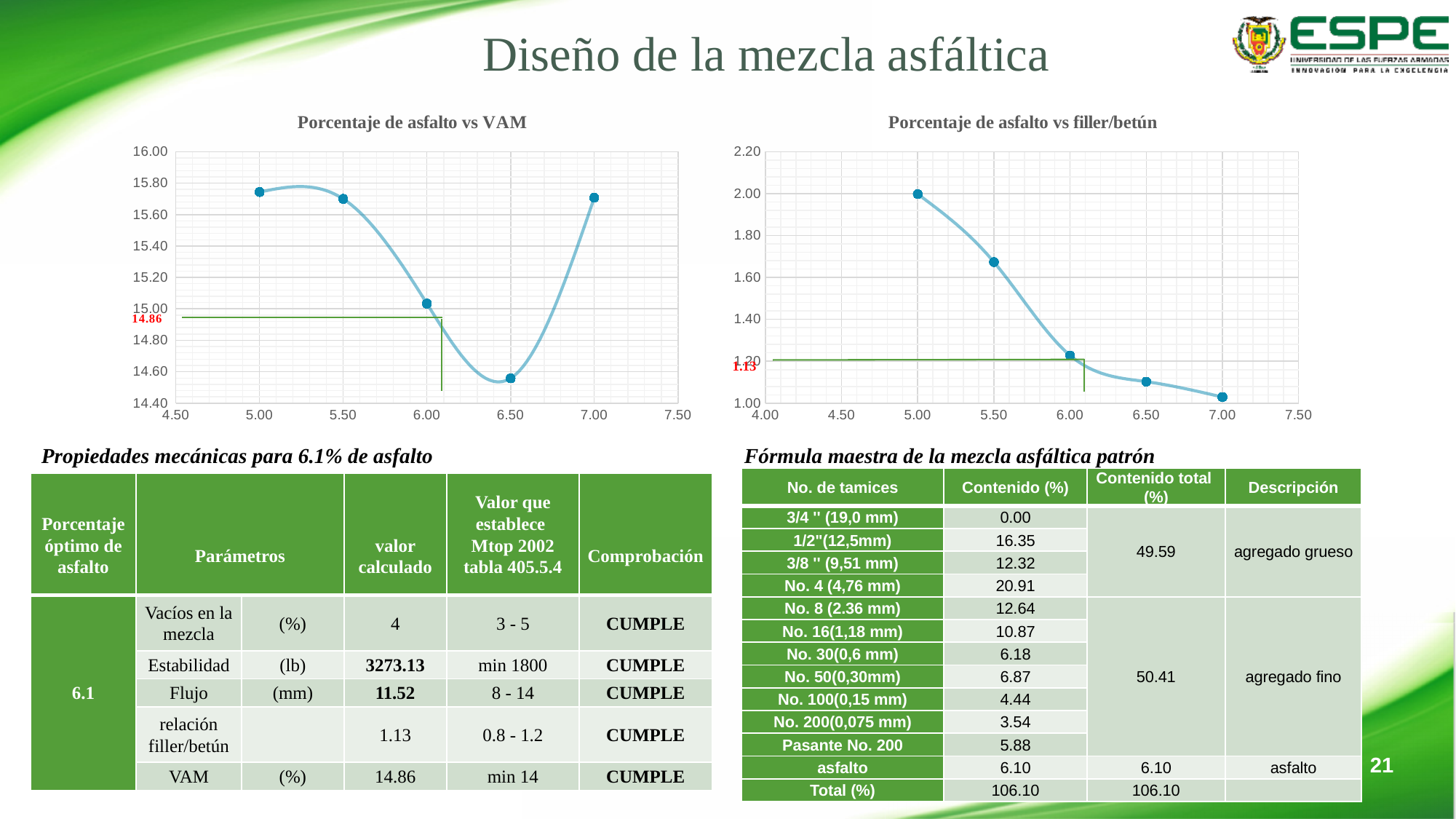
How many data points are plotted in the 'Porcentaje de asfalto vs filler/betún' chart? 5 In the 'Porcentaje de asfalto vs filler/betún' chart, at which asphalt percentage is the filler/betún value highest? 5.00 In the 'Porcentaje de asfalto vs VAM' chart, is the value at 6.50 greater or less than 14.80? less In the 'Porcentaje de asfalto vs VAM' chart, at which asphalt percentage is the VAM value lowest? 6.50 How many data points are plotted in the 'Porcentaje de asfalto vs VAM' chart? 5 What filler/betún value is marked in red on the 'Porcentaje de asfalto vs filler/betún' chart? 1.13 In the 'Porcentaje de asfalto vs filler/betún' chart, is the value at 5.50 greater or less than 1.60? greater What VAM value is marked in red on the 'Porcentaje de asfalto vs VAM' chart? 14.86 In the 'Porcentaje de asfalto vs filler/betún' chart, do the values rise or fall as the asphalt percentage increases from 5.00 to 7.00? fall In the 'Porcentaje de asfalto vs VAM' chart, is the value at 5.00 greater or less than 15.60? greater What kind of chart is 'Porcentaje de asfalto vs VAM'? line chart What is the title of the chart on the right side of the slide? Porcentaje de asfalto vs filler/betún